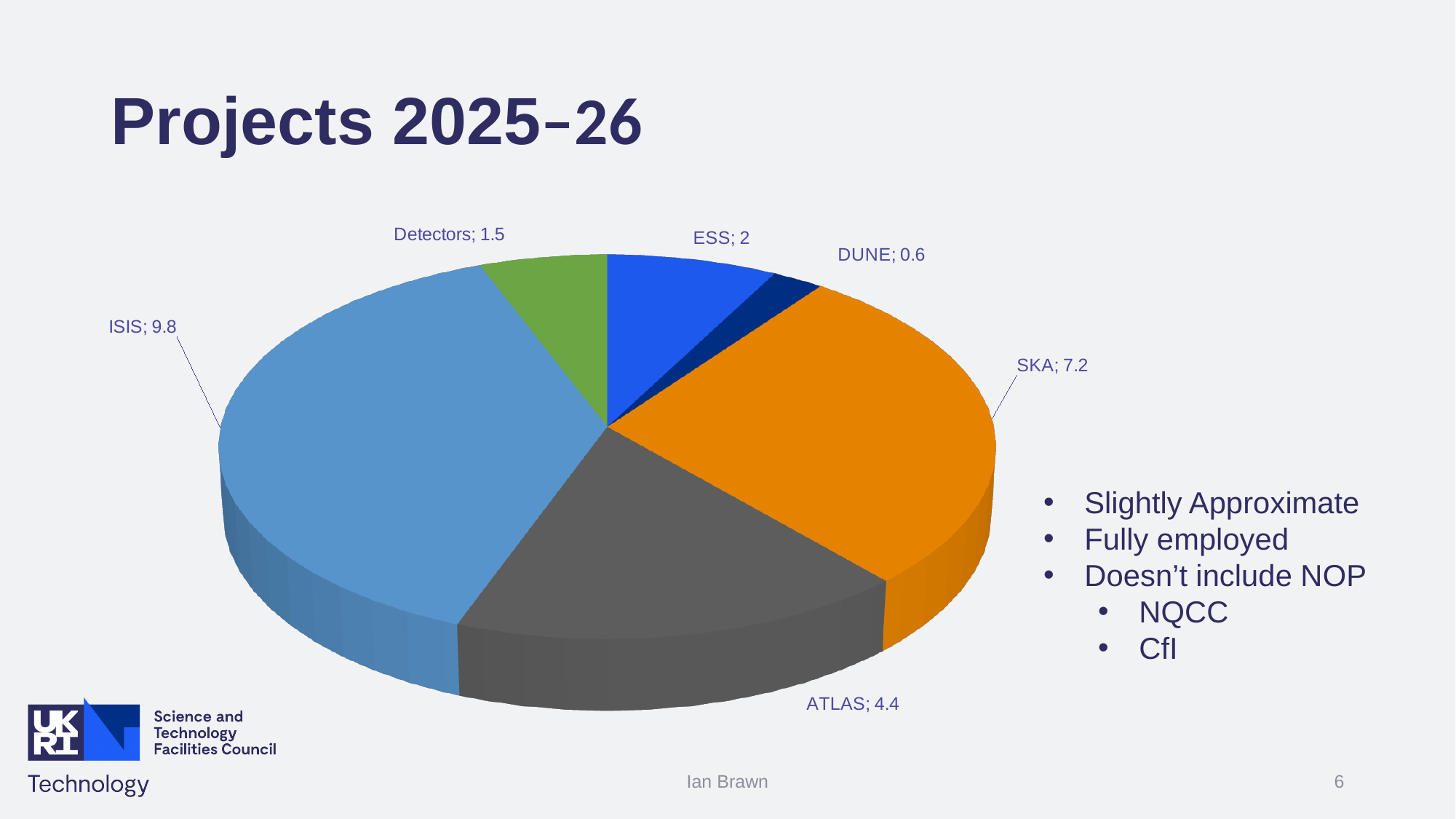
What is the value shown for Detectors? 1.5 Which project has the largest slice of the pie? ISIS What is the value shown for ISIS? 9.8 What is the sum of all the values shown in the pie chart? 25.5 What is the value shown for SKA? 7.2 What is the value shown for DUNE? 0.6 What kind of chart is shown on the slide? pie chart What is the difference between the values for ISIS and SKA? 2.6 How many projects are shown in the pie chart? 6 What colour is the SKA slice of the pie? orange Which is larger, the value for ATLAS or the value for ESS? ATLAS Which project has the smallest slice of the pie? DUNE